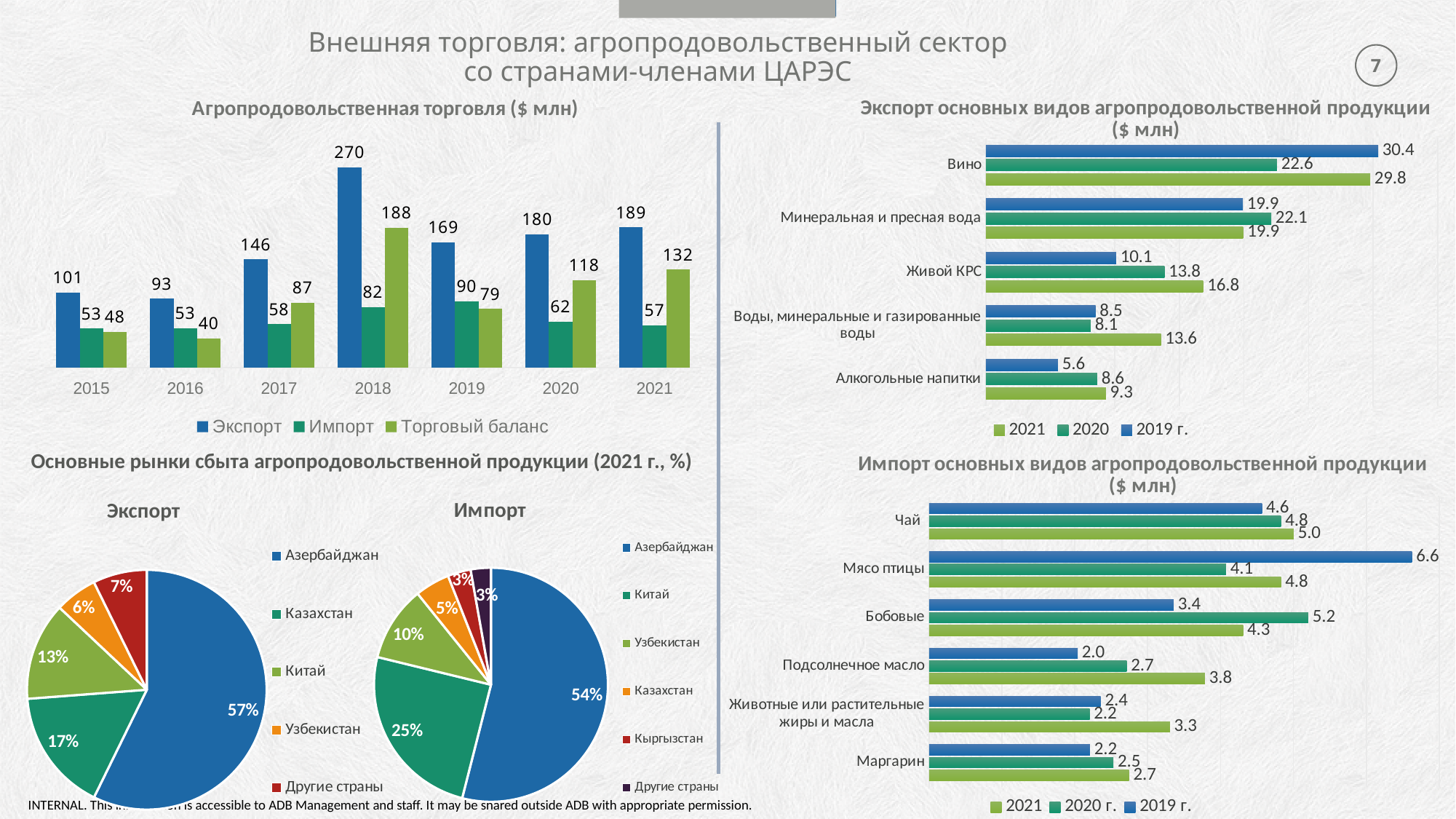
What type of chart is 'Экспорт основных видов агропродовольственной продукции ($ млн)'? Bar chart In the chart 'Экспорт основных видов агропродовольственной продукции ($ млн)', which is larger for Живой КРС: 2019 г. or 2021? 2021 In the chart 'Агропродовольственная торговля ($ млн)', how many series does the legend list? 3 In the 'Импорт' pie chart under 'Основные рынки сбыта агропродовольственной продукции (2021 г., %)', which country has the largest share? Азербайджан In the 'Экспорт' pie chart under 'Основные рынки сбыта агропродовольственной продукции (2021 г., %)', what share does Казахстан have? 17% In the chart 'Агропродовольственная торговля ($ млн)', which year has the highest Торговый баланс? 2018 In the chart 'Агропродовольственная торговля ($ млн)', how many years are shown on the x axis? 7 In the chart 'Импорт основных видов агропродовольственной продукции ($ млн)', what is the difference between the 2020 г. and 2021 values for Бобовые? 0.9 In the chart 'Экспорт основных видов агропродовольственной продукции ($ млн)', what is the value for Вино in 2021? 29.8 In the chart 'Импорт основных видов агропродовольственной продукции ($ млн)', what is the value for Мясо птицы in 2019 г.? 6.6 In the chart 'Агропродовольственная торговля ($ млн)', what is the value of Экспорт for 2018? 270 In the chart 'Агропродовольственная торговля ($ млн)', what is the difference between Экспорт and Импорт in 2021? 132